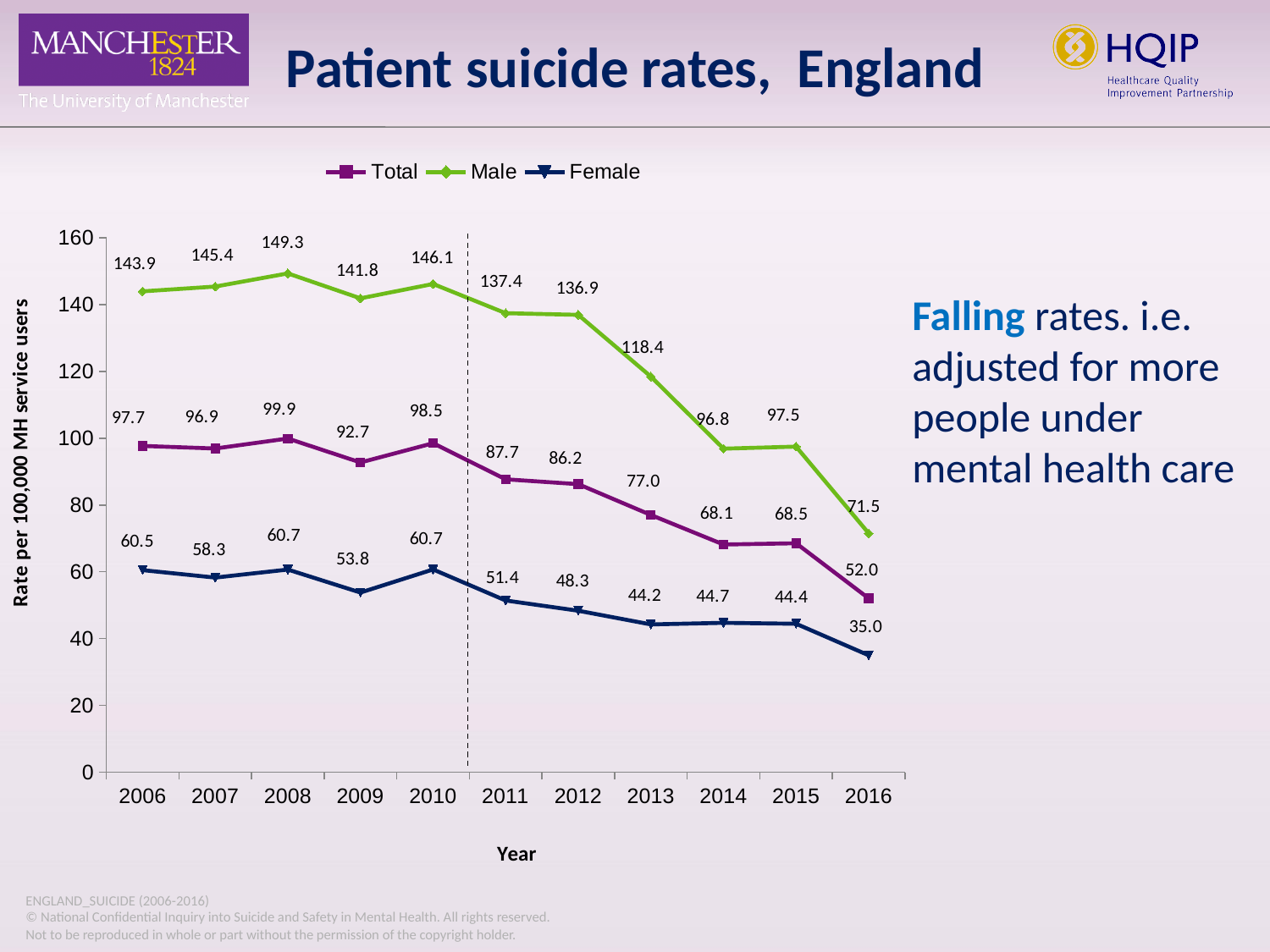
What is the Male rate in 2008? 149.3 What is the Total rate in 2011? 87.7 Is the Total rate in 2014 greater or less than 80? less Which is larger, the Female rate in 2010 or the Female rate in 2013? 2010 In which year is the Male rate highest? 2008 How many series does the legend list? 3 Do the Male rates rise or fall from 2010 to 2016? fall In which year is the Total rate lowest? 2016 How many years are shown on the x axis? 11 What is the difference between the Male rate in 2006 and in 2016? 72.4 What is the Female rate in 2016? 35.0 What kind of chart is shown? line chart